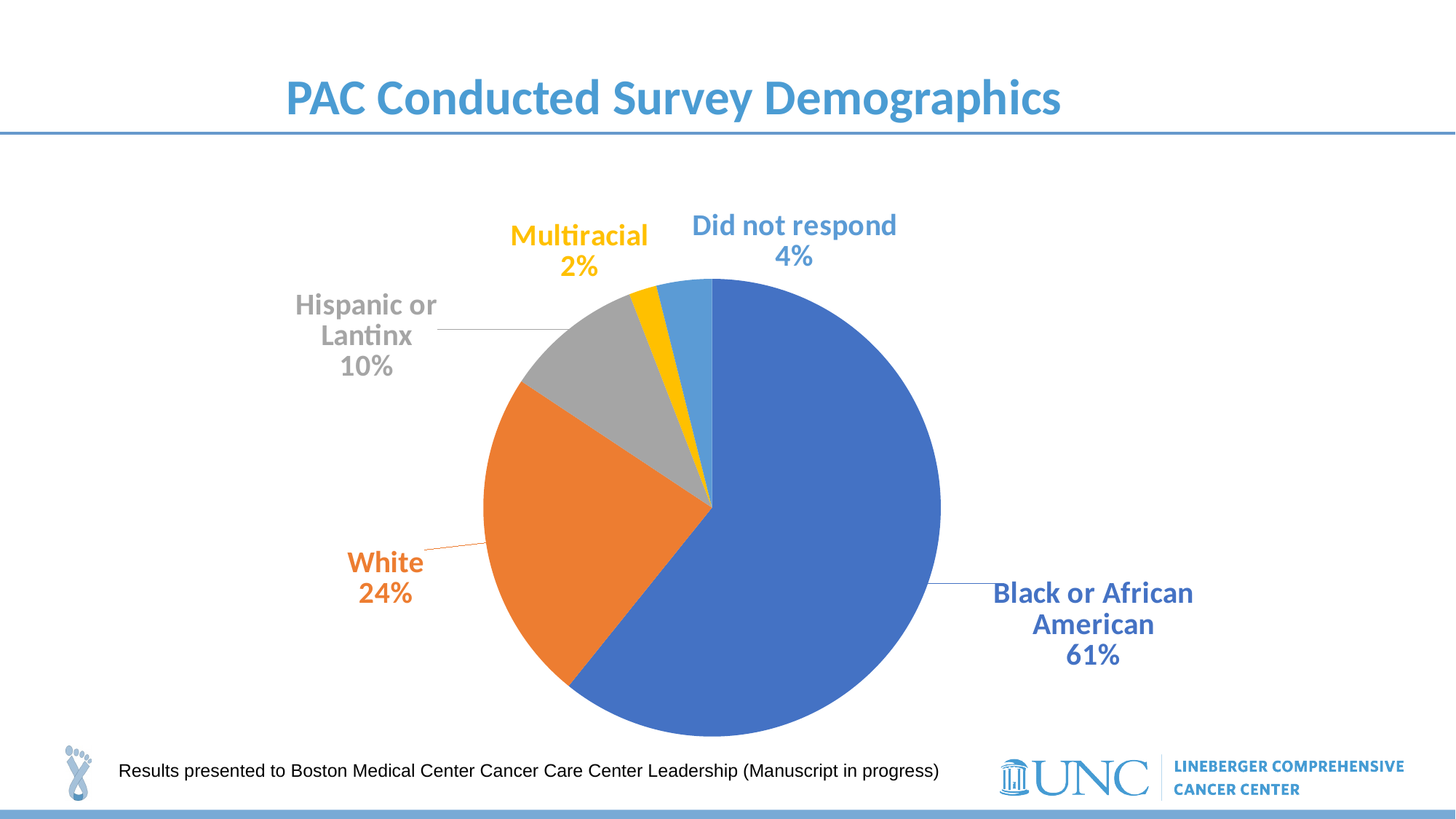
Which category has the largest share of the pie? Black or African American What is the title of the slide containing the pie chart? PAC Conducted Survey Demographics What percentage of survey respondents were Hispanic or Lantinx? 10% What kind of chart is shown on the slide? pie chart Which is larger, the Hispanic or Lantinx slice or the Did not respond slice? Hispanic or Lantinx What percentage of survey respondents were White? 24% What percentage of survey respondents were Black or African American? 61% How many categories are shown in the pie chart? 5 Which category has the smallest share of the pie? Multiracial What percentage of survey respondents did not respond? 4% What percentage of survey respondents were Multiracial? 2% What is the difference in percentage points between the Black or African American and White slices? 37